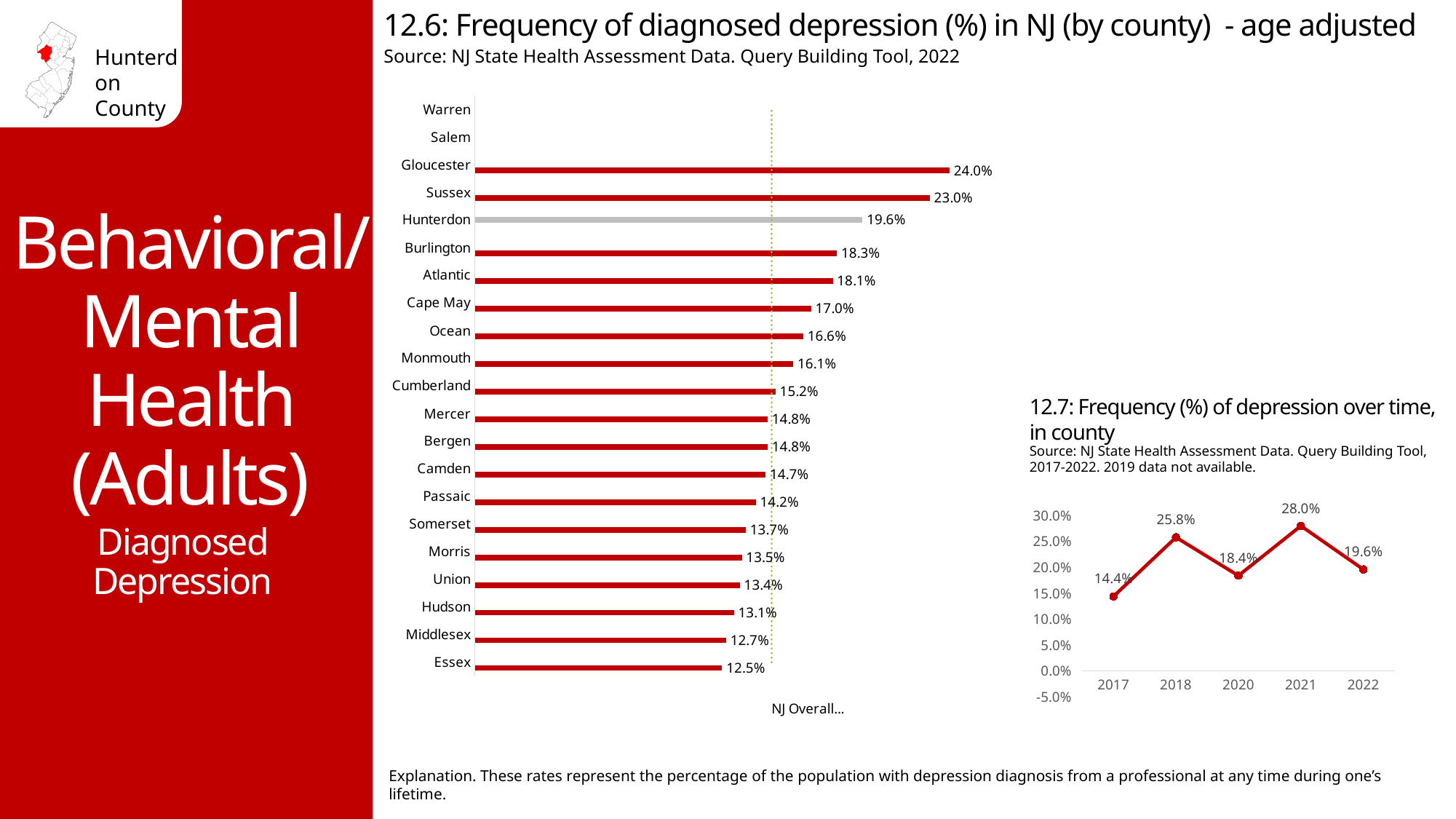
In chart 12.6, what is the difference between the values for Gloucester and Sussex? 1.0% In chart 12.7, what is the difference between the 2018 and 2020 values? 7.4% In chart 12.6, what kind of chart is used? Bar chart In chart 12.6, which county has a higher value, Burlington or Atlantic? Burlington In chart 12.6, which county has the highest frequency of diagnosed depression among those with a bar shown? Gloucester In chart 12.6, which county has the lowest frequency of diagnosed depression? Essex In chart 12.6, what is the value for Cape May? 17.0% In chart 12.7, how many data points are plotted? 5 In chart 12.7, what kind of chart is used? Line chart In chart 12.6, what is the frequency of diagnosed depression for Hunterdon? 19.6% In chart 12.7, which year has the lowest frequency of depression? 2017 In chart 12.7, what is the frequency of depression in 2021? 28.0%